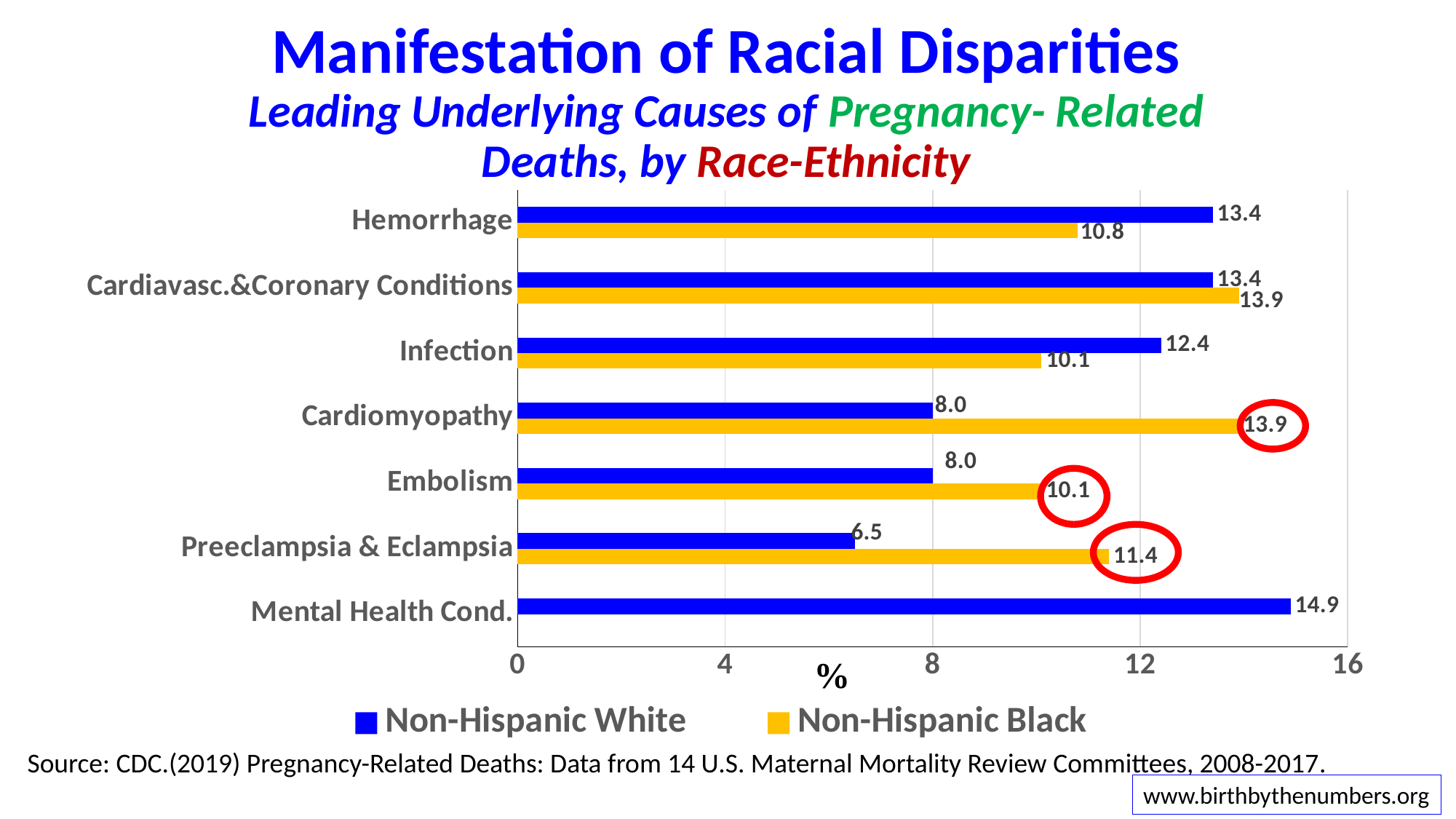
How many series does the legend list? 2 For Infection, which is larger: the Non-Hispanic White value or the Non-Hispanic Black value? Non-Hispanic White What is the Non-Hispanic White value for Mental Health Cond.? 14.9 What is the Non-Hispanic White value for Hemorrhage? 13.4 How many categories are shown on the y axis? 7 Which colour represents Non-Hispanic Black in the chart? Yellow What is the Non-Hispanic Black value for Cardiomyopathy? 13.9 What kind of chart is shown on the slide? Bar chart What is the Non-Hispanic Black value for Preeclampsia & Eclampsia? 11.4 Which category has the lowest Non-Hispanic White value? Preeclampsia & Eclampsia What is the difference between the Non-Hispanic Black and Non-Hispanic White values for Cardiomyopathy? 5.9 Which category has the highest Non-Hispanic White value? Mental Health Cond.